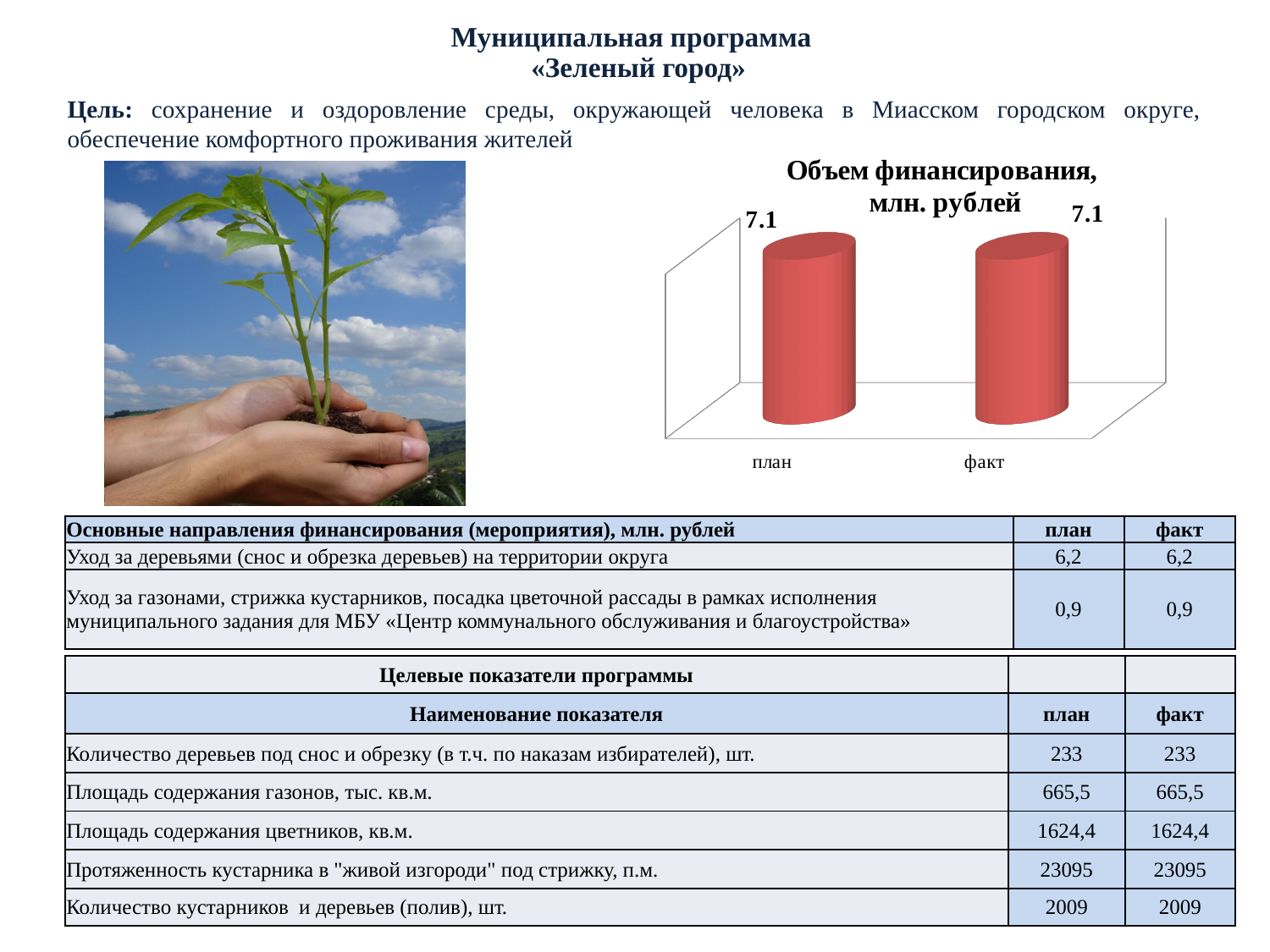
What is the value for факт in the chart? 7.1 Are the план and факт values in the chart equal? yes Does the value change from план to факт in the chart? no, it stays at 7.1 What kind of chart is shown on the slide? bar chart How many categories are shown in the chart? 2 What are the two category labels on the x axis of the chart? план, факт What is the value for план in the chart? 7.1 What is the title of the chart? Объем финансирования, млн. рублей What is the difference between the план and факт values in the chart? 0